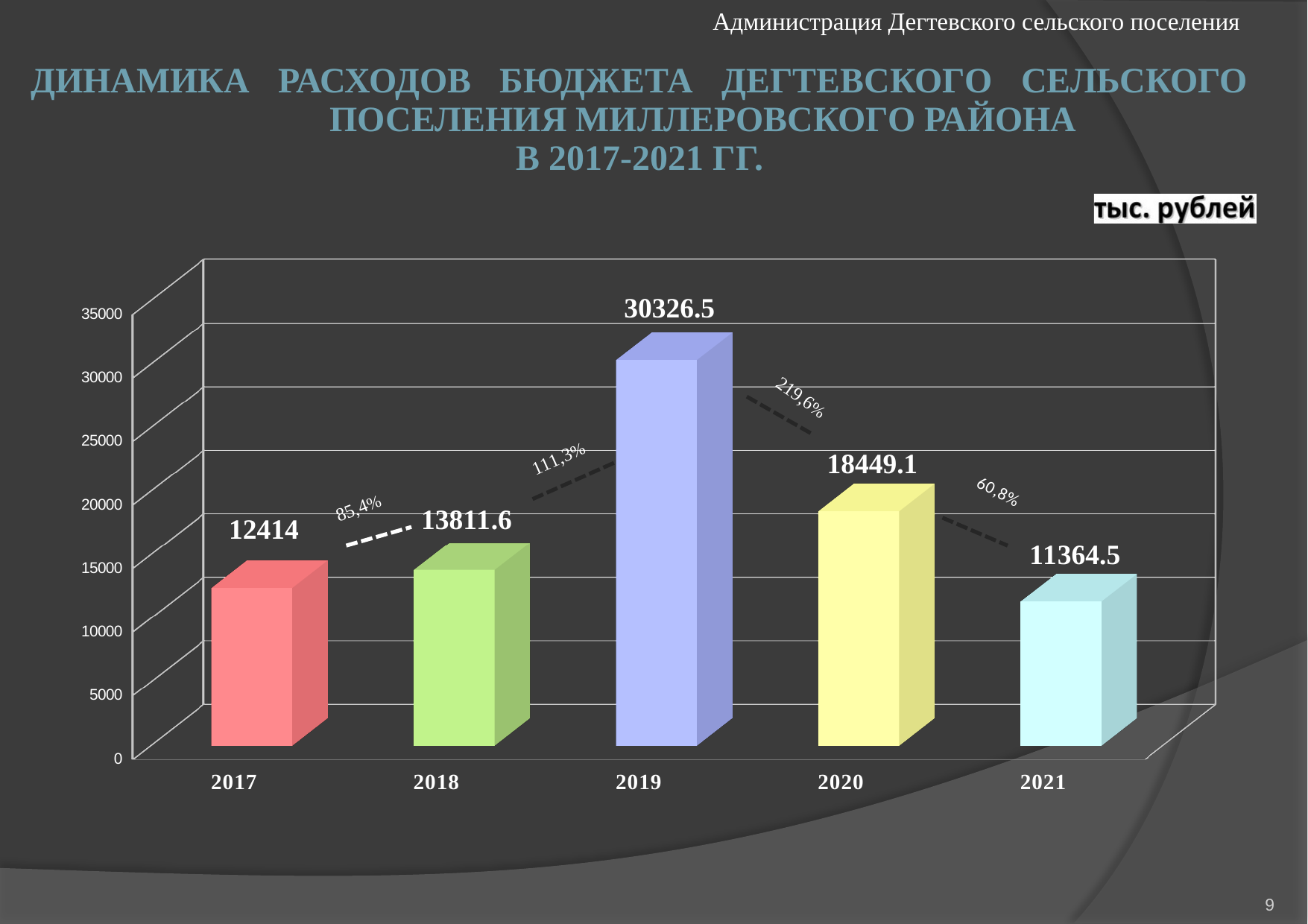
What kind of chart is shown on the slide? Bar chart What is the value shown for 2017? 12414 How many years (bars) are shown on the chart? 5 What is the value shown for 2021? 11364.5 What is the difference between the values for 2020 and 2021? 7084.6 What is the budget expenditure value shown for 2019? 30326.5 Which is larger, the value for 2017 or the value for 2021? 2017 Which year has the lowest expenditure value? 2021 Which year has the highest expenditure value? 2019 Do the values rise or fall from 2019 to 2021? Fall What percentage label is shown between the 2018 and 2019 bars? 111,3% What is the difference between the values for 2019 and 2018? 16514.9